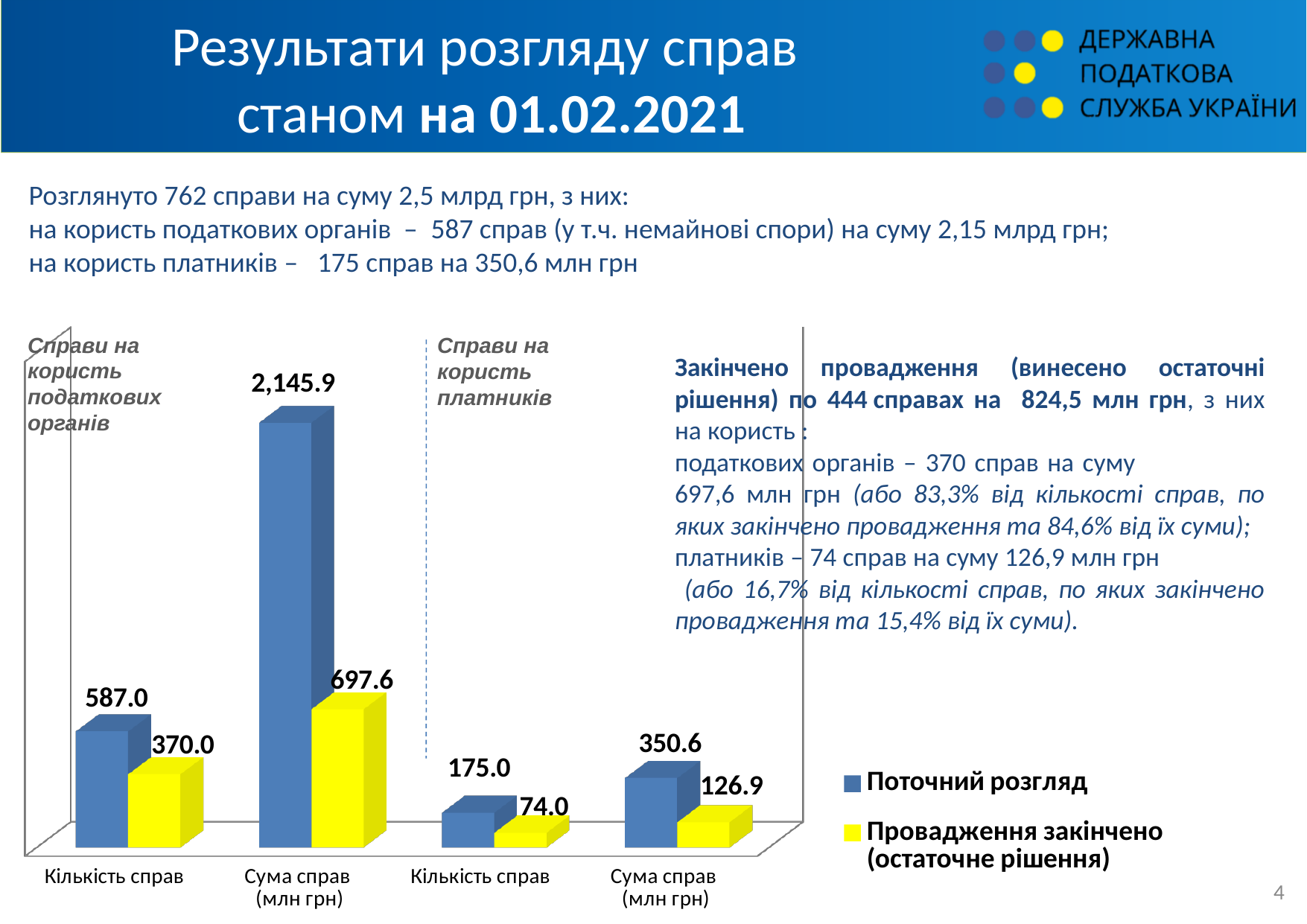
What is the difference between the "Поточний розгляд" and "Провадження закінчено (остаточне рішення)" values for "Сума справ (млн грн)" in the "Справи на користь платників" group? 223.7 What is the value of the "Провадження закінчено (остаточне рішення)" series for "Сума справ (млн грн)" in the "Справи на користь податкових органів" group? 697.6 How many categories are shown on the x axis of the chart? 4 Which is larger: the "Поточний розгляд" value for "Кількість справ" in the "Справи на користь платників" group, or the "Провадження закінчено (остаточне рішення)" value for "Кількість справ" in the "Справи на користь податкових органів" group? Провадження закінчено (остаточне рішення), Справи на користь податкових органів (370.0) What is the value of the "Поточний розгляд" series for "Сума справ (млн грн)" in the "Справи на користь платників" group? 350.6 What is the value of the "Провадження закінчено (остаточне рішення)" series for "Кількість справ" in the "Справи на користь платників" group? 74.0 Which bar in the chart has the lowest value? Провадження закінчено (остаточне рішення), Кількість справ, Справи на користь платників (74.0) What is the value of the "Поточний розгляд" series for "Кількість справ" in the "Справи на користь податкових органів" group? 587.0 What is the difference between the "Поточний розгляд" and "Провадження закінчено (остаточне рішення)" values for "Кількість справ" in the "Справи на користь податкових органів" group? 217.0 What kind of chart is shown on the slide? Bar chart How many series does the chart legend list? 2 Which bar in the chart has the highest value? Поточний розгляд, Сума справ (млн грн), Справи на користь податкових органів (2,145.9)